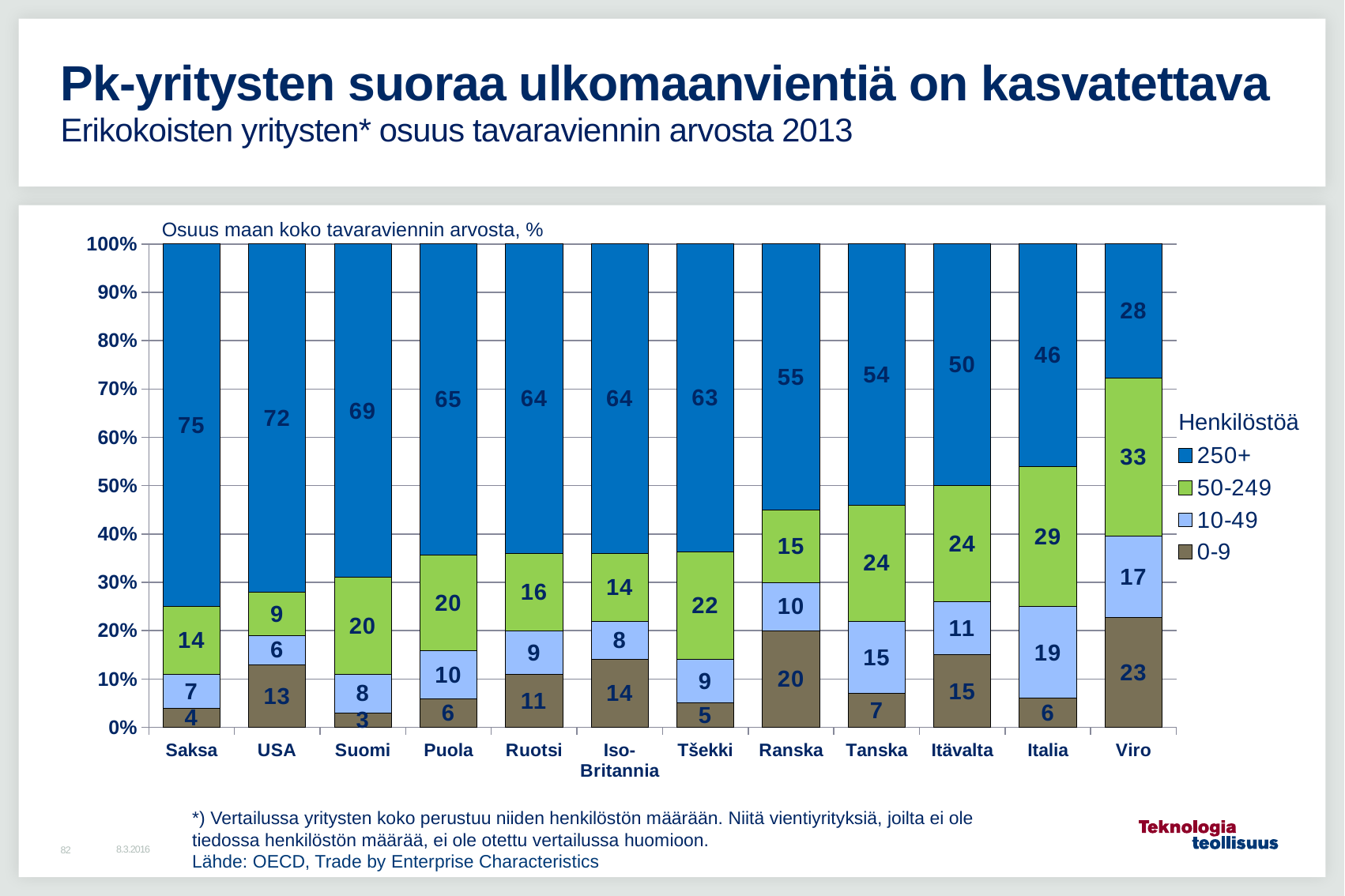
What is the value for the 250+ series for Saksa? 75 Which country has the lowest value for the 0-9 series? Suomi Do the values for the 250+ series rise or fall from Saksa to Viro along the x axis? Fall What is the value for the 50-249 series for Italia? 29 What is the difference between the 250+ values for Saksa and Viro? 47 What kind of chart is shown on the slide? Stacked bar chart What is the value for the 10-49 series for Tanska? 15 Which country has the highest value for the 250+ series? Saksa How many countries are shown on the x axis? 12 What is the value for the 0-9 series for Viro? 23 How many series does the legend list? 4 Which is larger, the 50-249 value for Viro or the 50-249 value for Tšekki? Viro